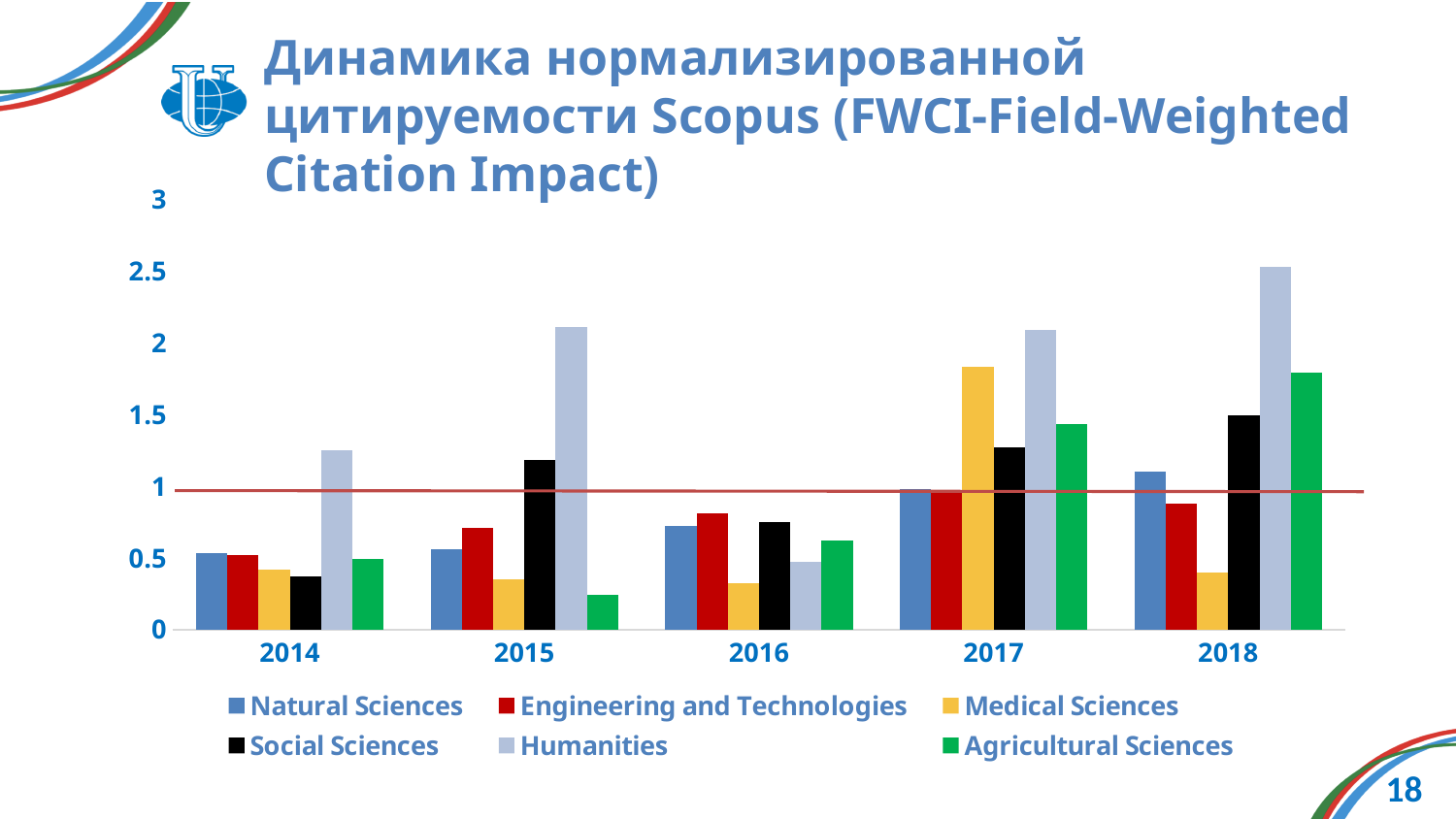
Does the value for Humanities rise or fall from 2016 to 2018? Rise Is the value for Medical Sciences in 2017 greater or less than 1.5? greater In 2015, which is larger: Social Sciences or Natural Sciences? Social Sciences Which series has the lowest value in 2016? Medical Sciences Which series has the lowest value in 2015? Agricultural Sciences Which series has the highest value in 2018? Humanities At what value is the horizontal reference line drawn across the chart? 1 What kind of chart is shown on the slide? Bar chart Is the value for Humanities in 2015 greater or less than 2? greater How many series does the legend list? 6 Is the value for Agricultural Sciences in 2018 greater or less than 1.5? greater How many years are shown on the x axis? 5